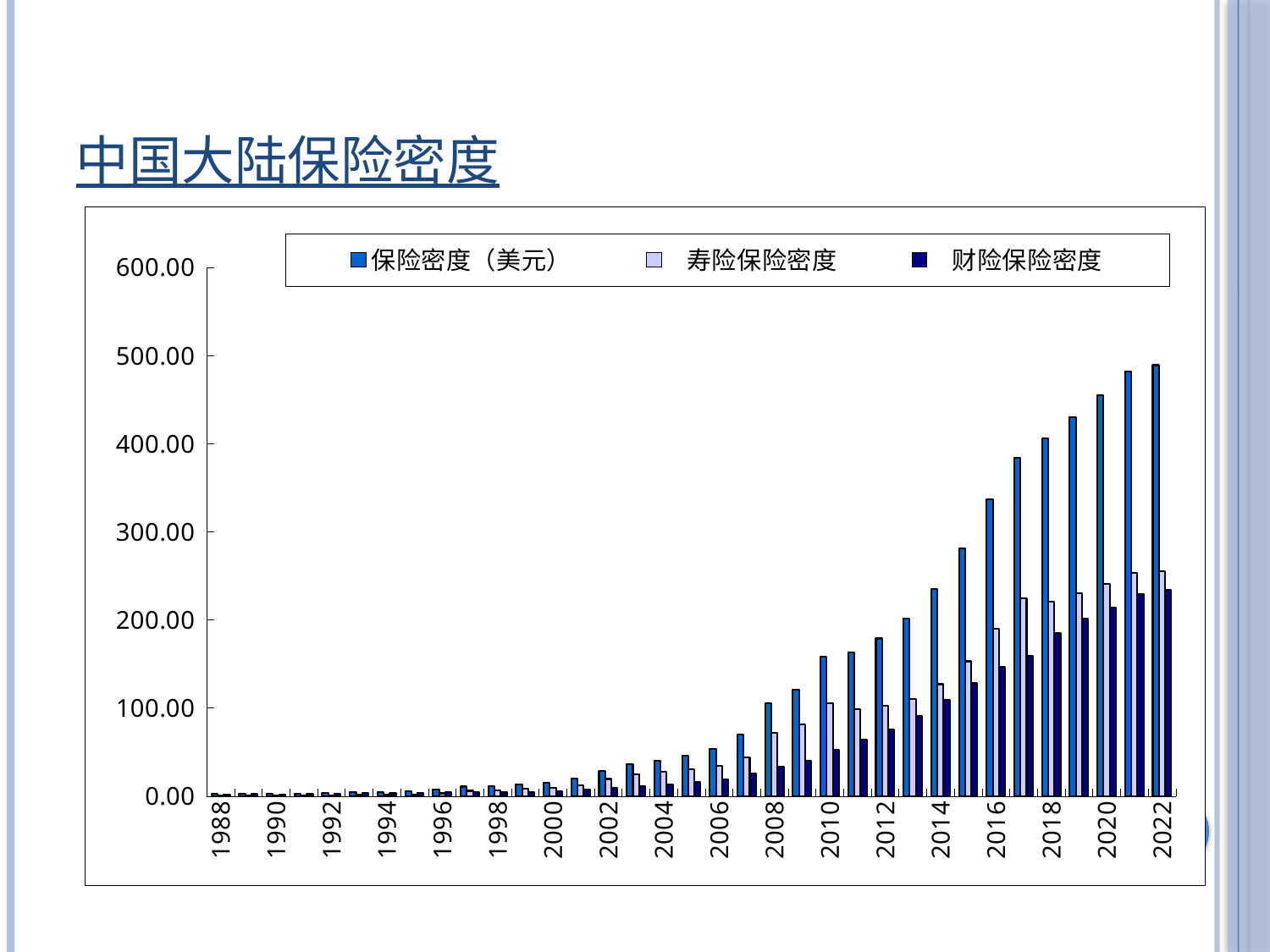
How many series does the legend list? 3 Is the value for 保险密度（美元） in 2016 greater or less than 300.00? greater Is the value for 保险密度（美元） in 2010 greater or less than 200.00? less Which series is shown in the lightest colour in the legend? 寿险保险密度 What is the title of the chart? 中国大陆保险密度 Do the values for 保险密度（美元） generally rise or fall from 1988 to 2022? rise In 2016, which is larger, 寿险保险密度 or 财险保险密度? 寿险保险密度 Is the value for 保险密度（美元） in 2022 greater or less than 400.00? greater In which year is 保险密度（美元） highest? 2022 How many years are plotted along the x axis, from 1988 to 2022? 35 What kind of chart is shown on the slide? bar chart